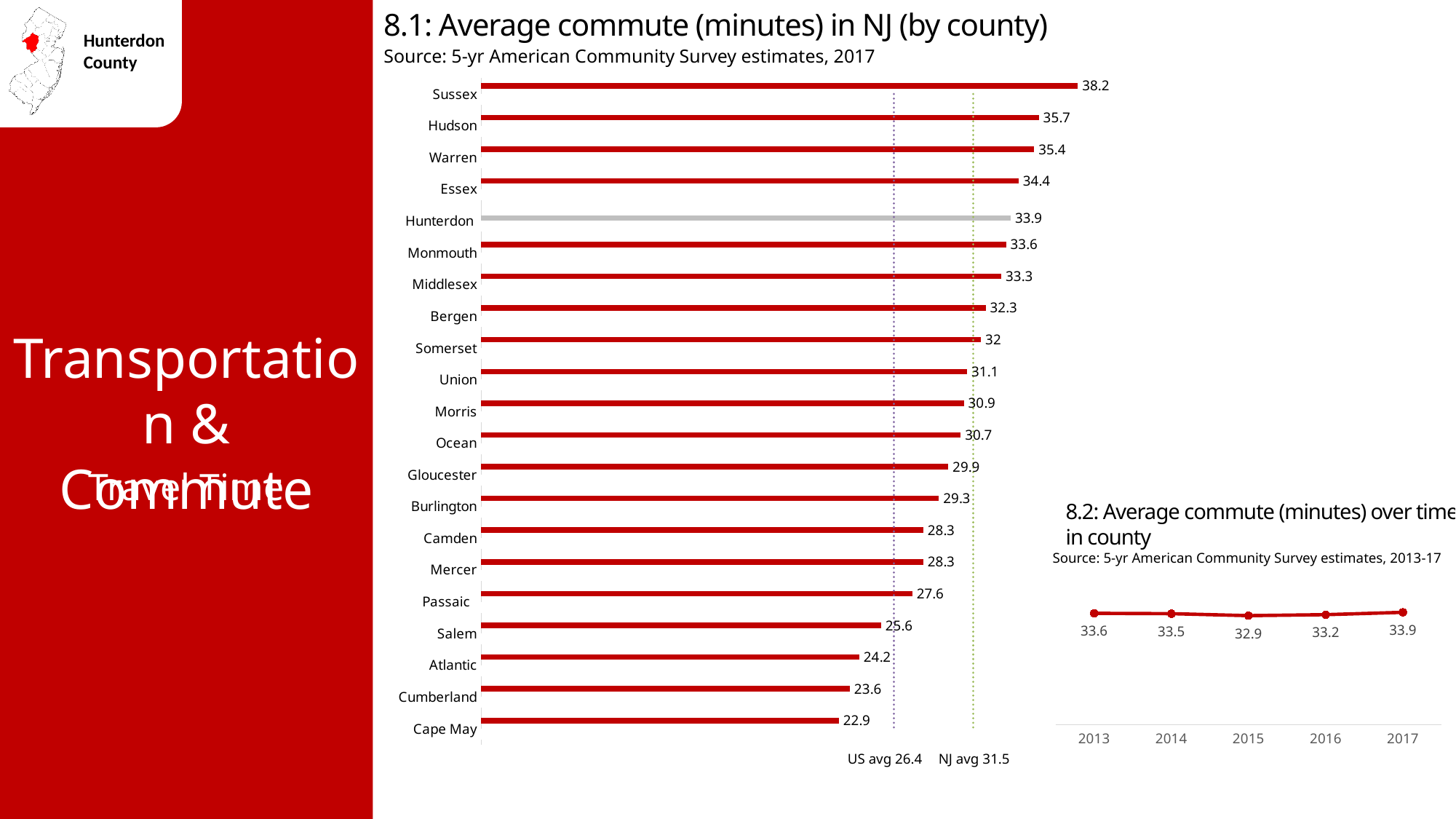
In chart 8.2 (Average commute over time in county), how many years are plotted? 5 In chart 8.1 (Average commute in NJ by county), which county has the highest average commute? Sussex In chart 8.2 (Average commute over time in county), what is the value for 2015? 32.9 In chart 8.1 (Average commute in NJ by county), what is the average commute for Hunterdon? 33.9 In chart 8.1 (Average commute in NJ by county), what NJ average is marked by the dotted line? 31.5 In chart 8.1 (Average commute in NJ by county), what is the difference between Sussex and Cape May? 15.3 In chart 8.1 (Average commute in NJ by county), which county has the lowest average commute? Cape May In chart 8.1 (Average commute in NJ by county), how many counties are shown? 21 In chart 8.1 (Average commute in NJ by county), which has a longer average commute, Bergen or Morris? Bergen What kind of chart is chart 8.1 (Average commute in NJ by county)? Bar chart In chart 8.1 (Average commute in NJ by county), what is the value for Passaic? 27.6 In chart 8.2 (Average commute over time in county), which year has the highest value? 2017